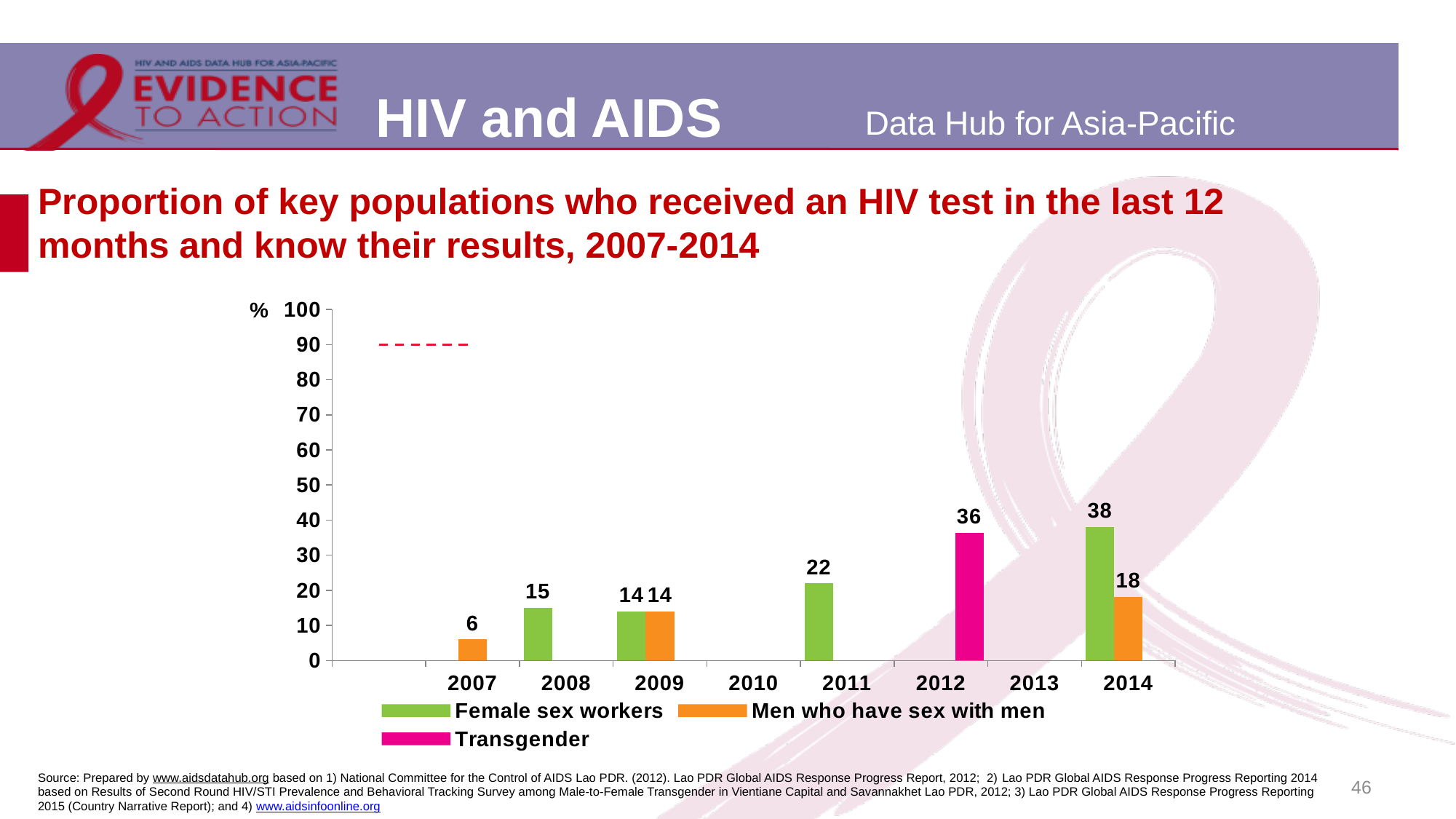
What is the difference between the Female sex workers and Men who have sex with men values in 2014? 20 What is the value for Female sex workers in 2014? 38 By how much did the Female sex workers value increase from 2011 to 2014? 16 How many series does the legend list? 3 Do the Female sex workers values rise or fall from 2009 to 2014? Rise What kind of chart is shown on the slide? Bar chart In which year is the Female sex workers value highest? 2014 Which is larger: the Female sex workers value in 2011 or in 2008? 2011 What is the value for Men who have sex with men in 2009? 14 What is the value for Transgender in 2012? 36 In which year is the Female sex workers value lowest? 2009 What is the value for Men who have sex with men in 2007? 6